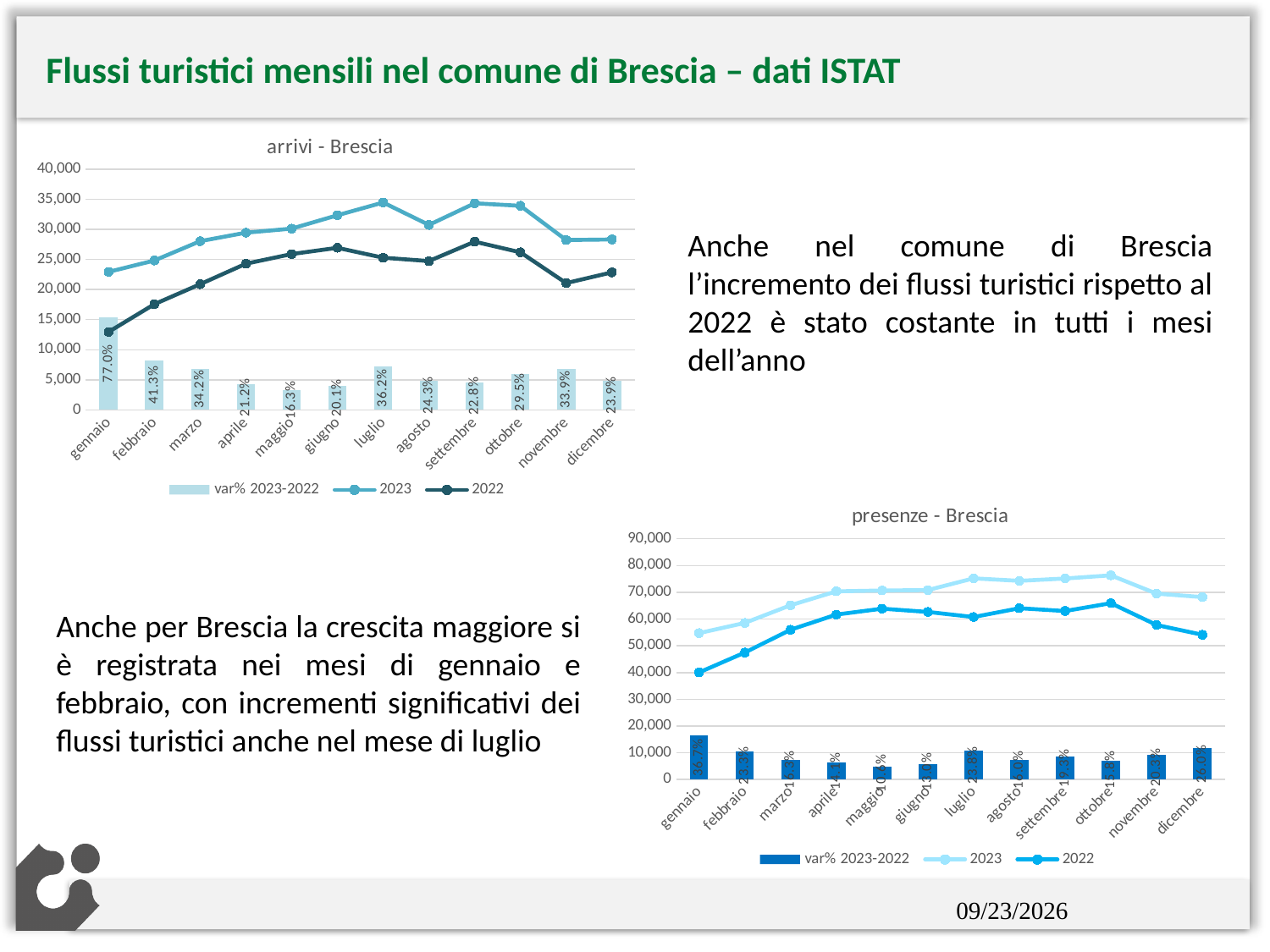
In the 'arrivi - Brescia' chart, is the 2022 value for gennaio greater or less than 15,000? less In the 'arrivi - Brescia' chart, what is the var% 2023-2022 value for luglio? 36.2% How many series does the legend of the 'presenze - Brescia' chart list? 3 In the 'arrivi - Brescia' chart, which month has a larger var% 2023-2022, ottobre or agosto? ottobre In the 'arrivi - Brescia' chart, what is the difference between the var% 2023-2022 for gennaio and febbraio? 35.7% In the 'presenze - Brescia' chart, is the 2023 value for ottobre greater or less than 70,000? greater In the 'arrivi - Brescia' chart, which month has the highest var% 2023-2022? gennaio In the 'arrivi - Brescia' chart, which month has the lowest var% 2023-2022? maggio In the 'arrivi - Brescia' chart, is the 2023 value for luglio greater or less than 30,000? greater How many months are shown on the x axis of the 'presenze - Brescia' chart? 12 In the 'arrivi - Brescia' chart, what is the var% 2023-2022 value for gennaio? 77.0% In the 'presenze - Brescia' chart, what is the var% 2023-2022 value for gennaio? 36.7%